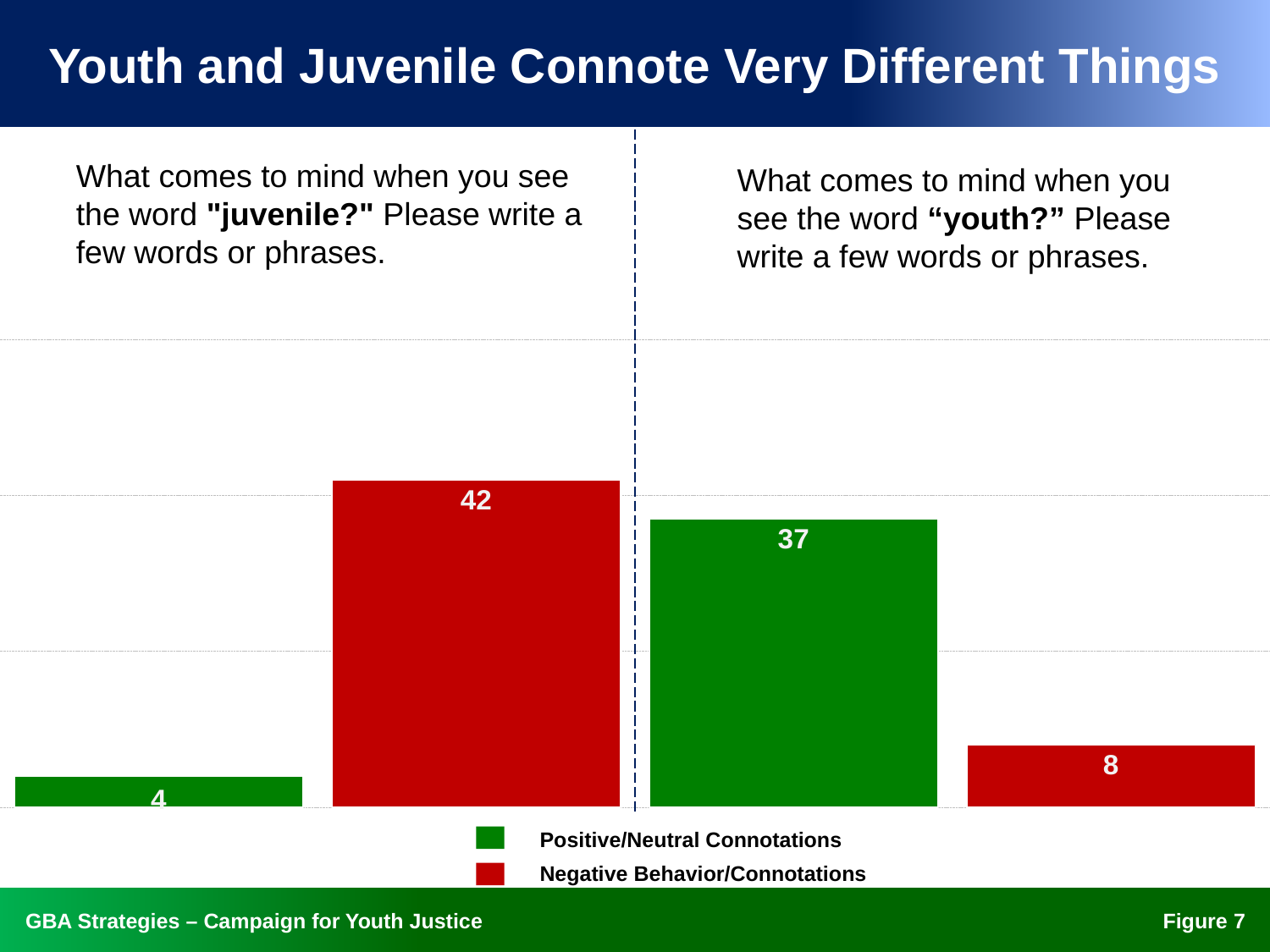
What is the difference between the Negative Behavior/Connotations value for "juvenile" and the Negative Behavior/Connotations value for "youth"? 34 What colour represents Negative Behavior/Connotations in the legend? Red What is the value of the Positive/Neutral Connotations bar for the word "youth"? 37 What is the difference between the Positive/Neutral Connotations value for "youth" and the Positive/Neutral Connotations value for "juvenile"? 33 What is the value of the Negative Behavior/Connotations bar for the word "youth"? 8 Which bar on the chart has the highest value? Negative Behavior/Connotations for "juvenile" (42) How many series does the legend list? 2 Which bar on the chart has the lowest value? Positive/Neutral Connotations for "juvenile" (4) Which is larger: the Positive/Neutral Connotations value for "youth" or the Negative Behavior/Connotations value for "youth"? Positive/Neutral Connotations for "youth" What is the value of the Negative Behavior/Connotations bar for the word "juvenile"? 42 What is the value of the Positive/Neutral Connotations bar for the word "juvenile"? 4 What kind of chart is shown on the slide? Bar chart